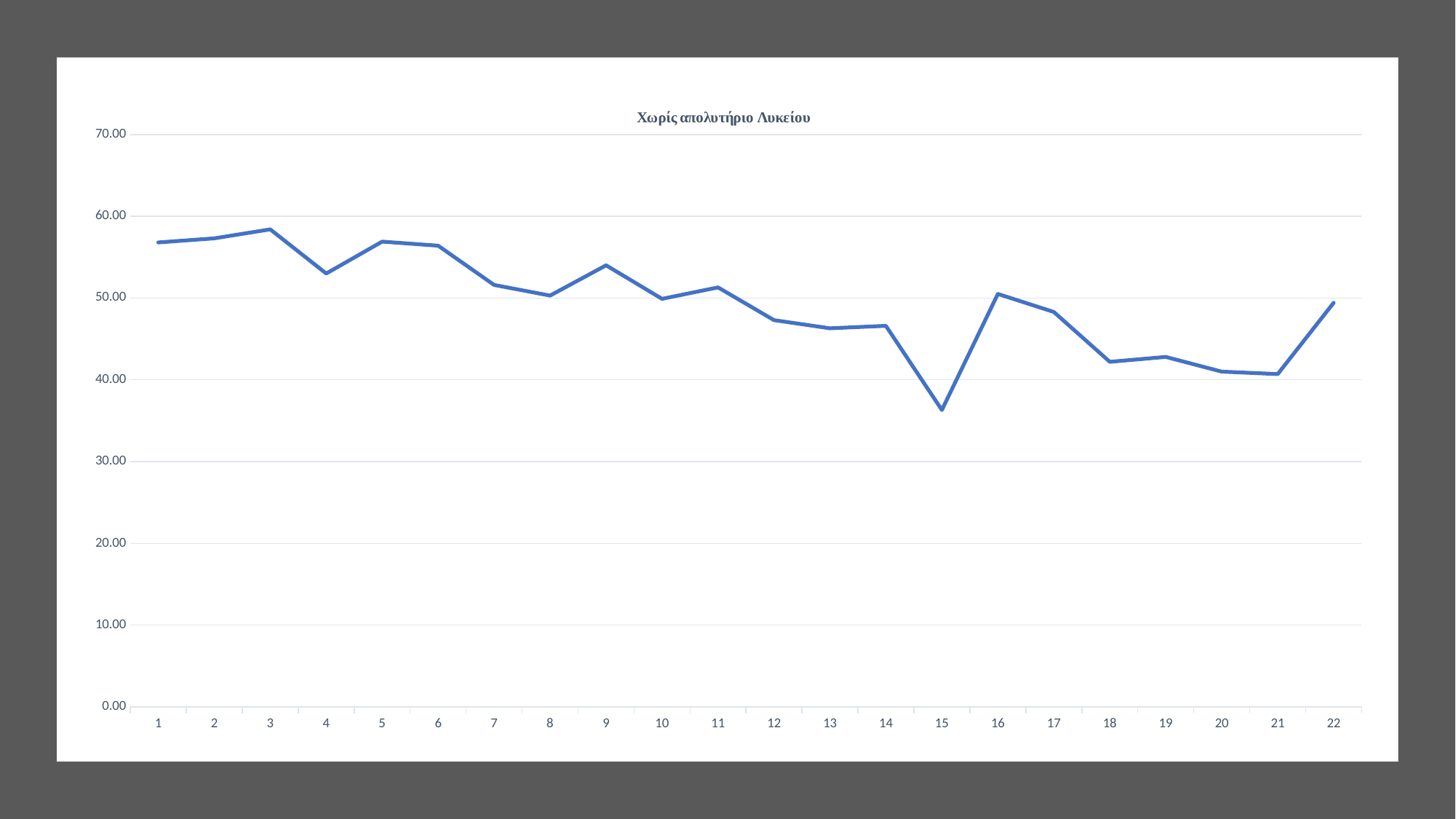
What kind of chart is shown on the slide? line chart What is the title of the chart? Χωρίς απολυτήριο Λυκείου At which x-axis point is the value lowest? 15 Overall, do the values rise or fall from point 1 to point 21? fall How many points are plotted along the x axis? 22 Is the value at point 3 greater or less than 50.00? greater At which x-axis point is the value highest? 3 Which has the larger value, point 4 or point 15? point 4 Is the value at point 16 greater or less than 40.00? greater Is the value at point 15 greater or less than 40.00? less Which has the larger value, point 18 or point 9? point 9